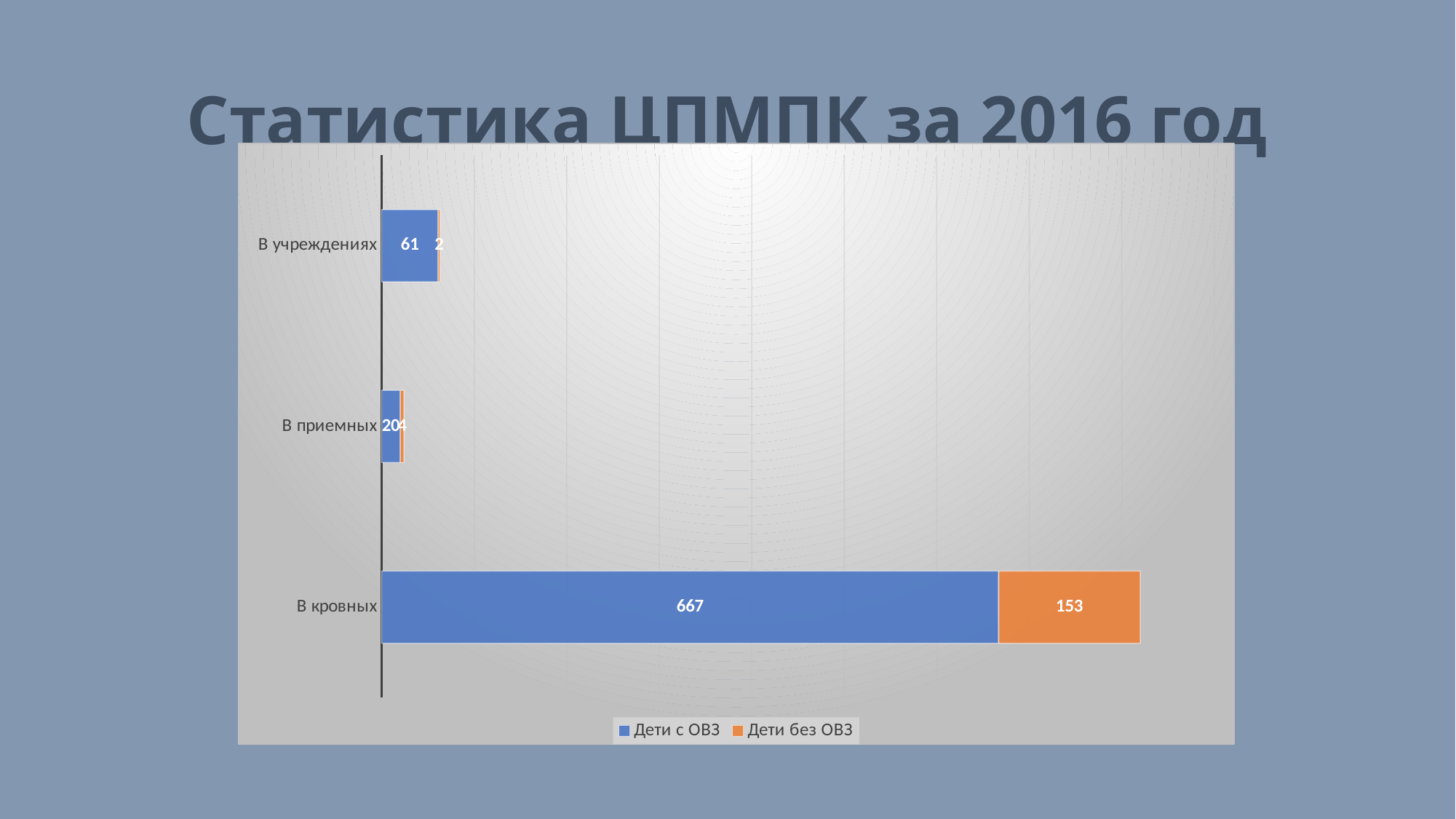
Which category has the highest value for Дети с ОВЗ? В кровных What is the value of Дети с ОВЗ for В учреждениях? 61 What kind of chart is shown on the slide? Stacked bar chart What is the total of the stacked bar for В учреждениях? 63 What is the value of Дети без ОВЗ for В кровных? 153 How many categories are shown on the chart? 3 What is the total of the stacked bar for В кровных? 820 What is the value of Дети без ОВЗ for В учреждениях? 2 How many series does the legend list? 2 What is the value of Дети с ОВЗ for В кровных? 667 What is the difference between Дети с ОВЗ and Дети без ОВЗ for В кровных? 514 Which category has the lowest value for Дети с ОВЗ? В приемных